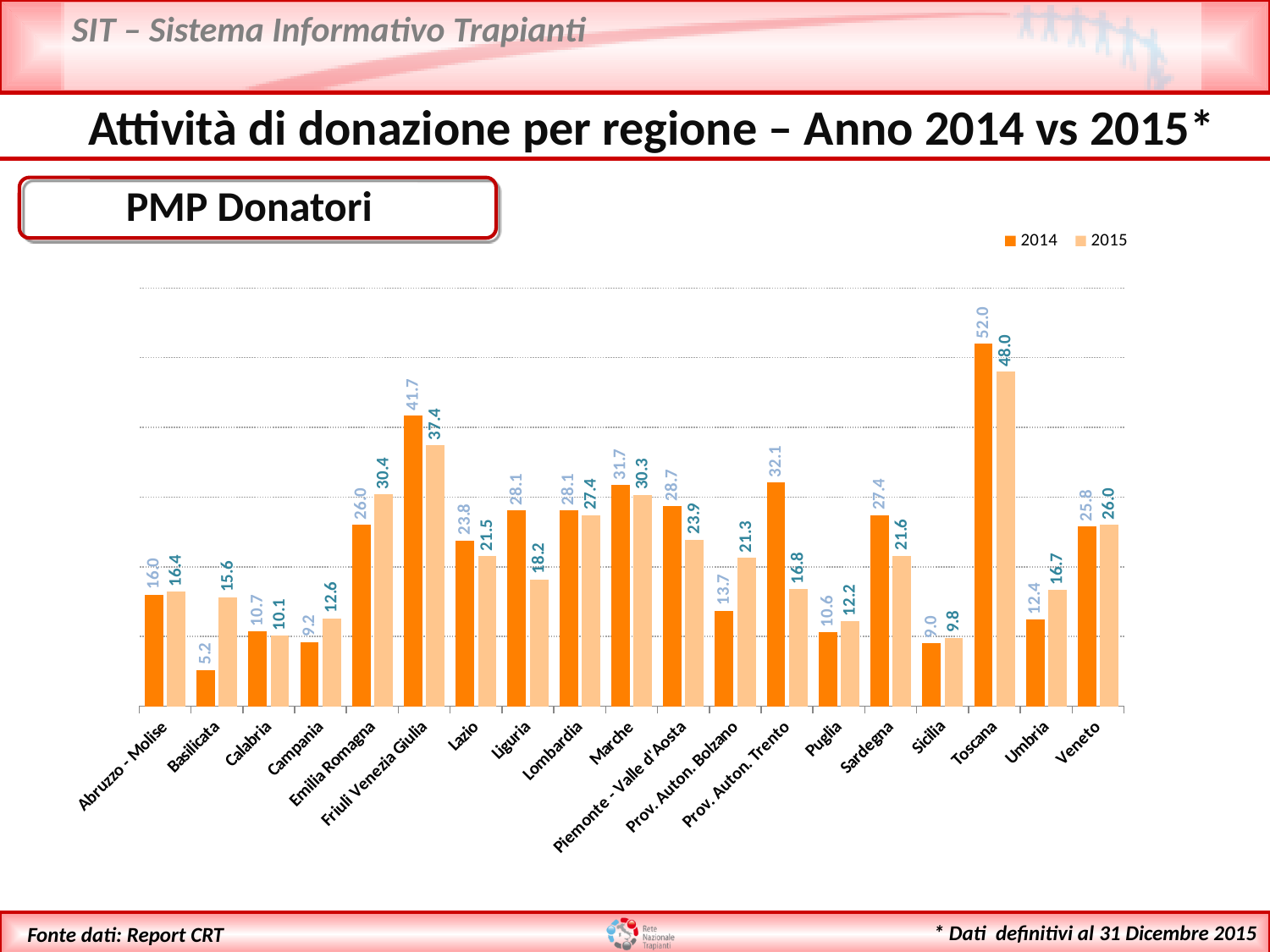
How many series does the legend list? 2 What is the difference between the 2014 and 2015 values for Basilicata? 10.4 Which is larger for Liguria: the 2014 value or the 2015 value? 2014 What is the PMP Donatori value for Toscana in 2014? 52.0 What type of chart is shown on the slide? Bar chart What is the 2014 value for Prov. Auton. Trento? 32.1 Which region has the highest 2015 value? Toscana How many regions are shown on the x axis of the chart? 19 Which region has the lowest 2014 value? Basilicata What is the 2015 value for Friuli Venezia Giulia? 37.4 By how much did Toscana's value fall from 2014 to 2015? 4.0 Which is larger for Prov. Auton. Bolzano: the 2014 value or the 2015 value? 2015